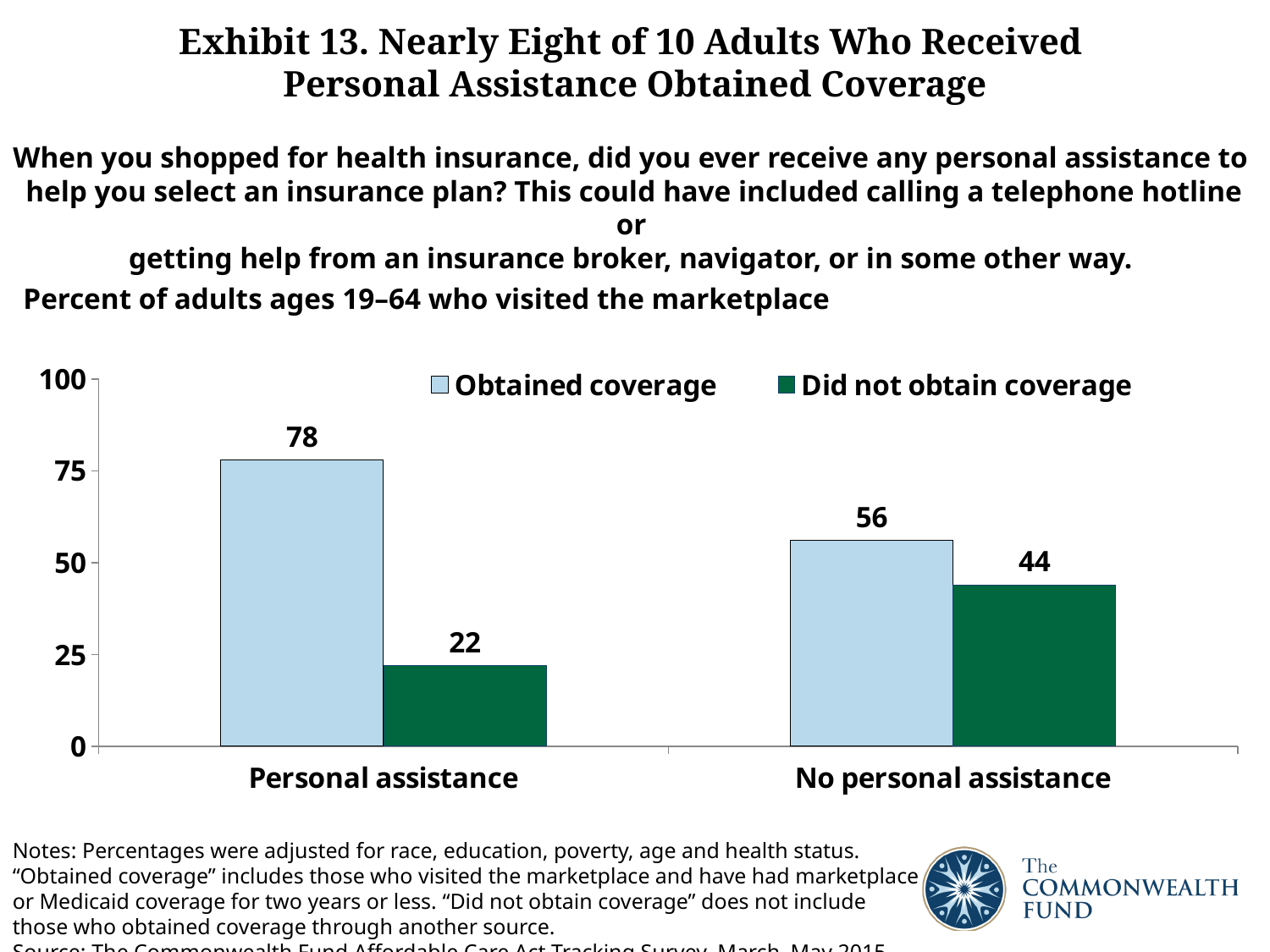
How many series does the legend list? 2 Which category has the highest 'Obtained coverage' value? Personal assistance What is the value for 'Did not obtain coverage' in the 'Personal assistance' category? 22 Which legend entry is shown in dark green? Did not obtain coverage Which is larger: 'Obtained coverage' or 'Did not obtain coverage' for 'No personal assistance'? Obtained coverage What is the value for 'Obtained coverage' in the 'No personal assistance' category? 56 What kind of chart is shown on the slide? Bar chart What is the difference between the 'Obtained coverage' values for 'Personal assistance' and 'No personal assistance'? 22 What percent of adults who received personal assistance obtained coverage? 78 Which category has the lowest 'Did not obtain coverage' value? Personal assistance How many categories are shown on the x axis? 2 What is the value for 'Did not obtain coverage' in the 'No personal assistance' category? 44